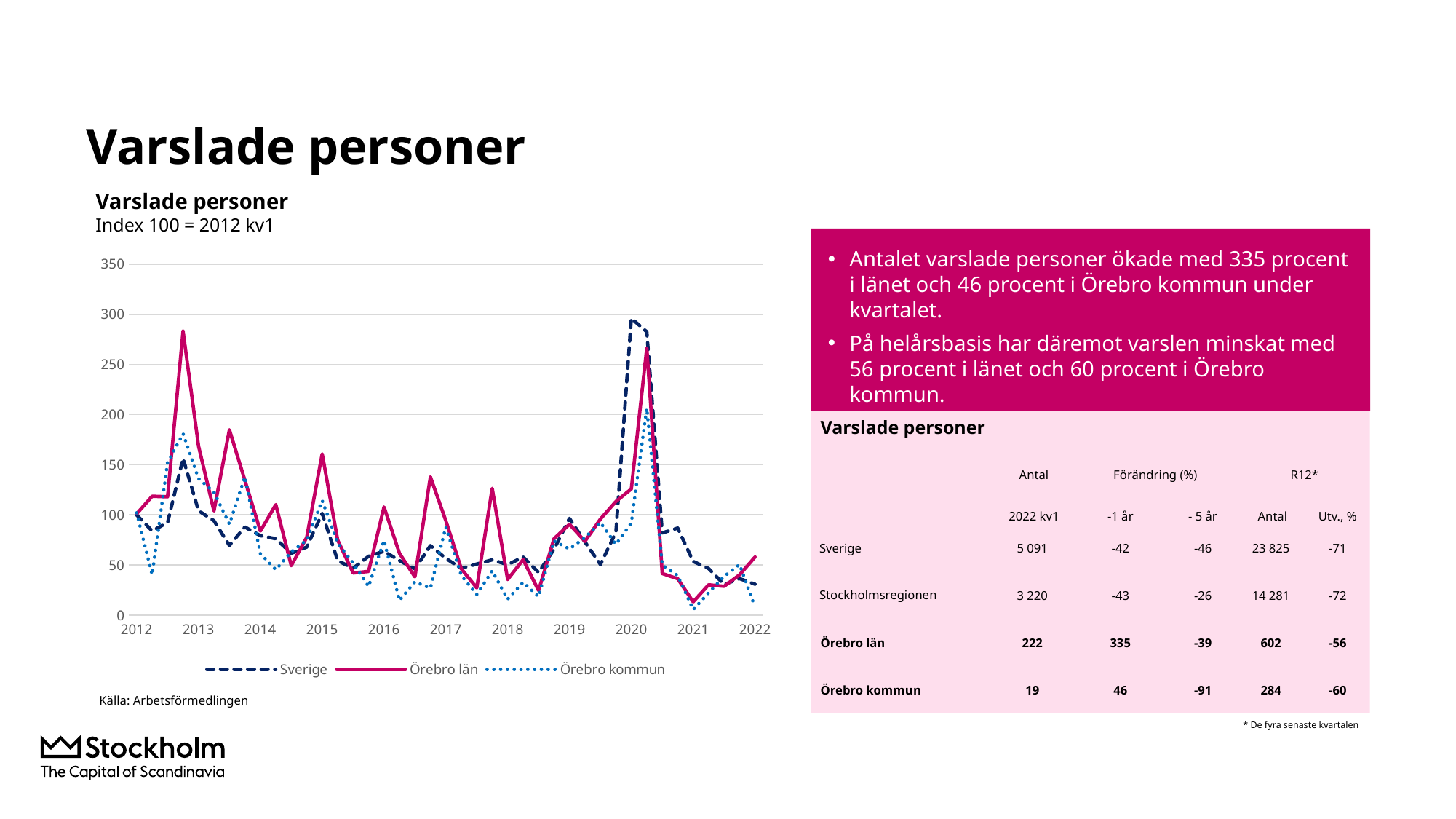
How many year labels are shown on the x axis? 11 Is the peak value for Örebro kommun in 2020 greater or less than 150? greater Which series reaches the highest peak in 2012? Örebro län Which series reaches the highest peak in 2020? Sverige Is the peak value for Örebro län in 2012 greater or less than 250? greater What is the index value for all series at 2012 kv1? 100 What is the title of the chart? Varslade personer Is the value for Sverige at the end of the series in 2022 greater or less than 50? less What source is given for the chart? Arbetsförmedlingen How many series does the chart legend list? 3 What kind of chart is shown on the slide? line chart